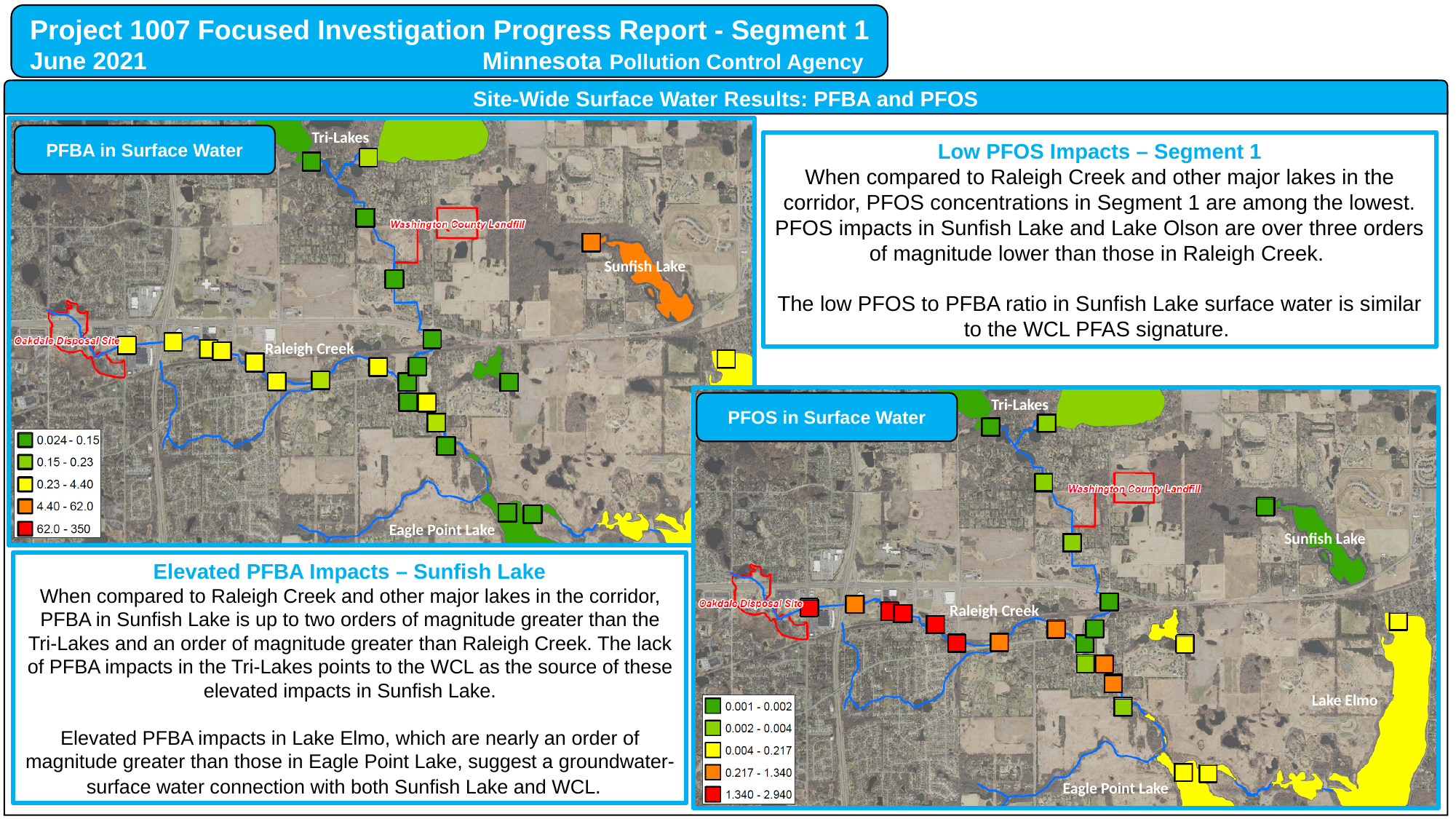
On the PFBA in Surface Water map, what concentration range does the orange legend colour represent? 4.40 - 62.0 On the PFOS in Surface Water map, which concentration range does the sample marker at Sunfish Lake fall in? 0.001 - 0.002 What is the title of the map in the lower right of the slide? PFOS in Surface Water On the PFBA in Surface Water map, what concentration range does the yellow legend colour represent? 0.23 - 4.40 On the PFBA in Surface Water map, how many concentration ranges does the legend list? 5 On the PFBA in Surface Water map, which concentration range does the sample marker at Sunfish Lake fall in? 4.40 - 62.0 On the PFOS in Surface Water map, how many concentration ranges does the legend list? 5 What is the title of the map in the upper left of the slide? PFBA in Surface Water On the PFOS in Surface Water map, what concentration range does the dark green legend colour represent? 0.001 - 0.002 On the PFOS in Surface Water map, what concentration range does the yellow legend colour represent? 0.004 - 0.217 On the PFBA in Surface Water map, what concentration range does the red legend colour represent? 62.0 - 350 On the PFOS in Surface Water map, what concentration range does the red legend colour represent? 1.340 - 2.940